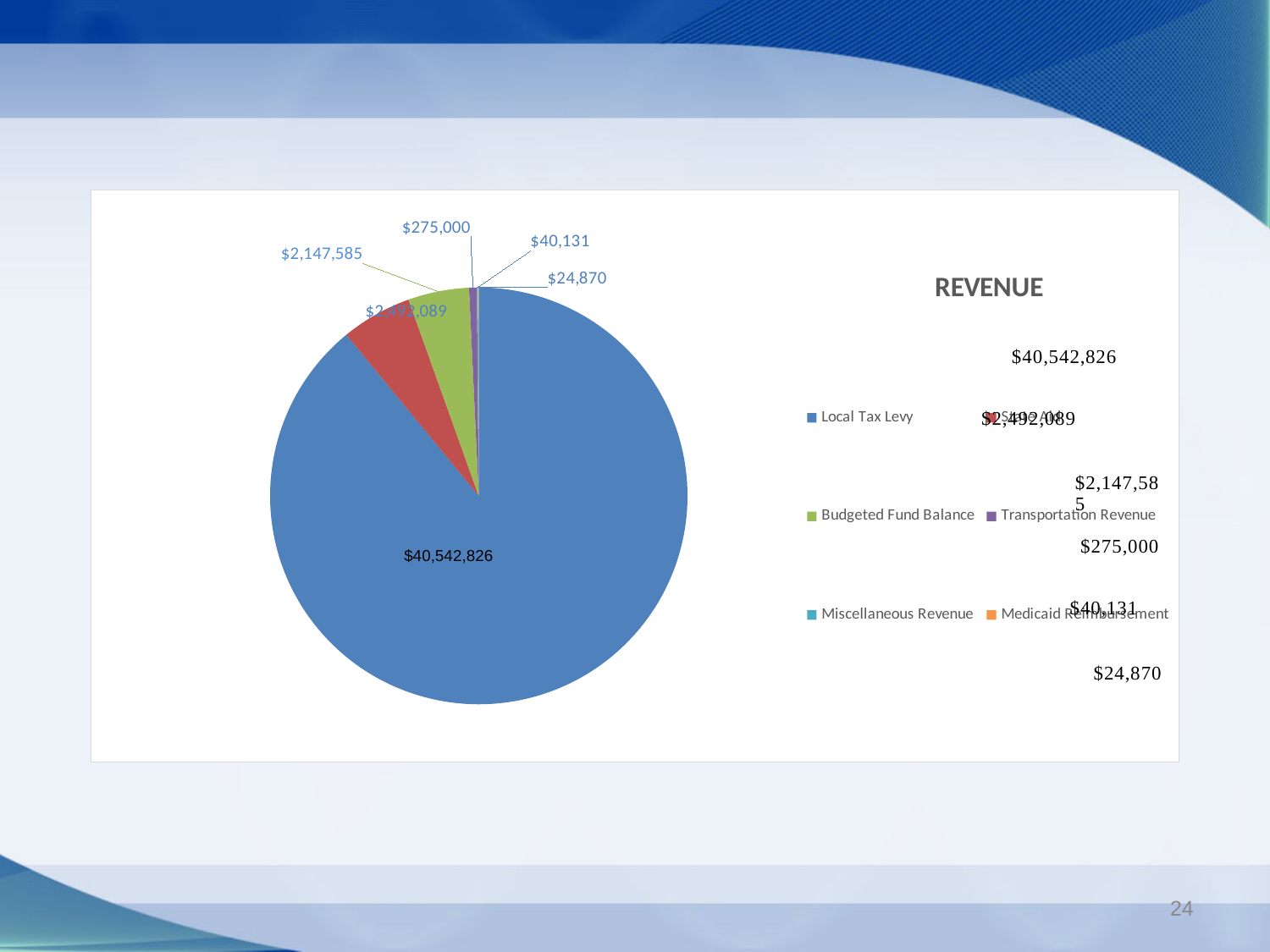
What is the value for Medicaid Reimbursement? $24,870 What is the value for Local Tax Levy? $40,542,826 What is the title of the chart? REVENUE What is the difference between Budgeted Fund Balance and Transportation Revenue? $1,872,585 Which category has the largest slice of the pie? Local Tax Levy Which is larger, Budgeted Fund Balance or Transportation Revenue? Budgeted Fund Balance What is the value for Budgeted Fund Balance? $2,147,585 What is the value for Miscellaneous Revenue? $40,131 What is the value for Transportation Revenue? $275,000 Which category has the smallest value? Medicaid Reimbursement How many slices does the pie chart have? 6 What type of chart is shown on the slide? Pie chart